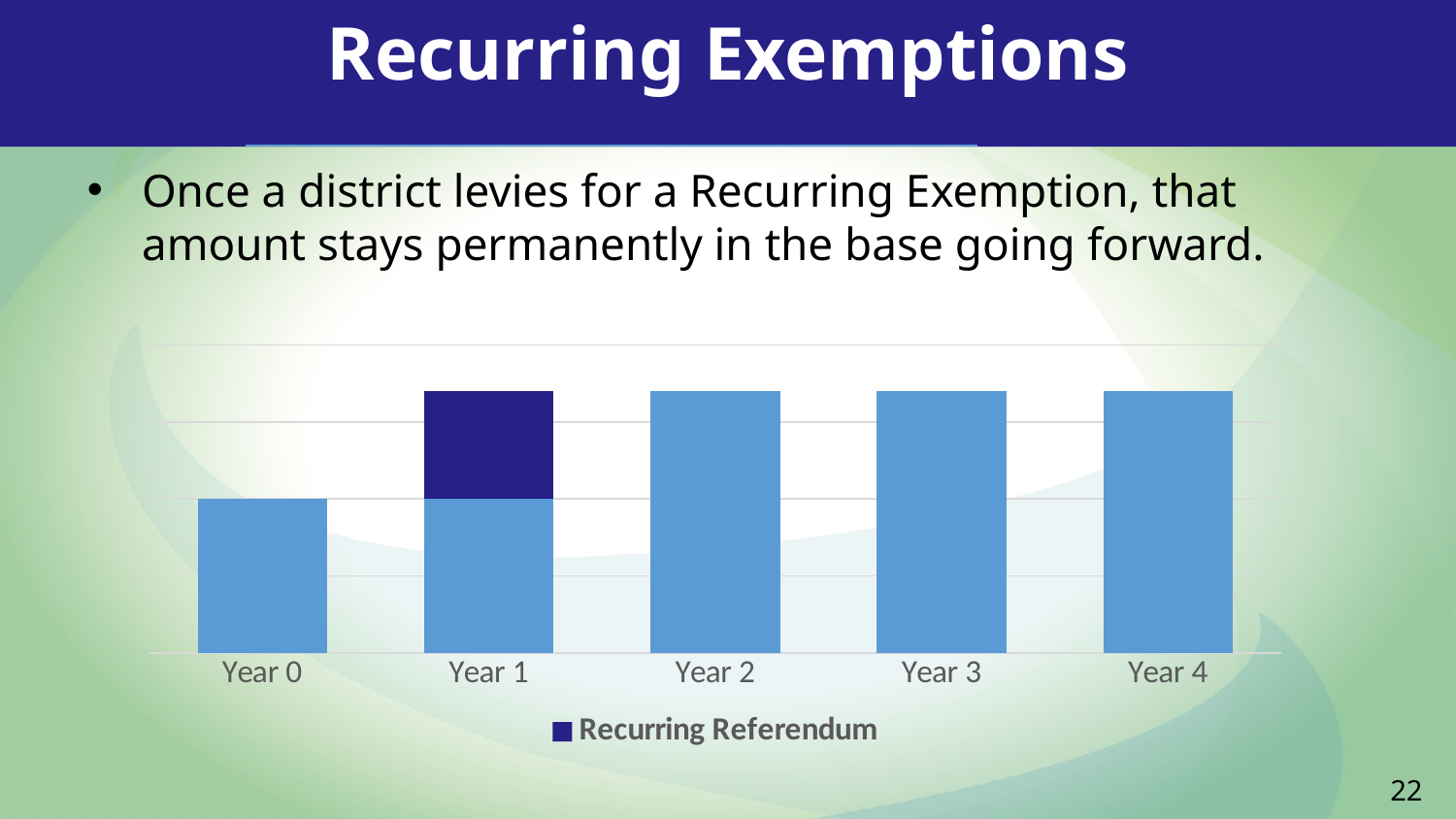
Which category has the lowest bar in the chart? Year 0 Which bar is larger, Year 3 or Year 0? Year 3 What kind of chart is shown on the slide? Bar chart What is the series name shown in the chart's legend? Recurring Referendum Which bar is larger, Year 0 or Year 2? Year 2 How many series does the chart's legend list? 1 Does the bar height rise or fall from Year 0 to Year 1? Rise Which category's bar contains a dark blue segment stacked on top? Year 1 How many categories are shown on the x axis of the chart? 5 What is the label of the first category on the x axis? Year 0 What is the label of the last category on the x axis? Year 4